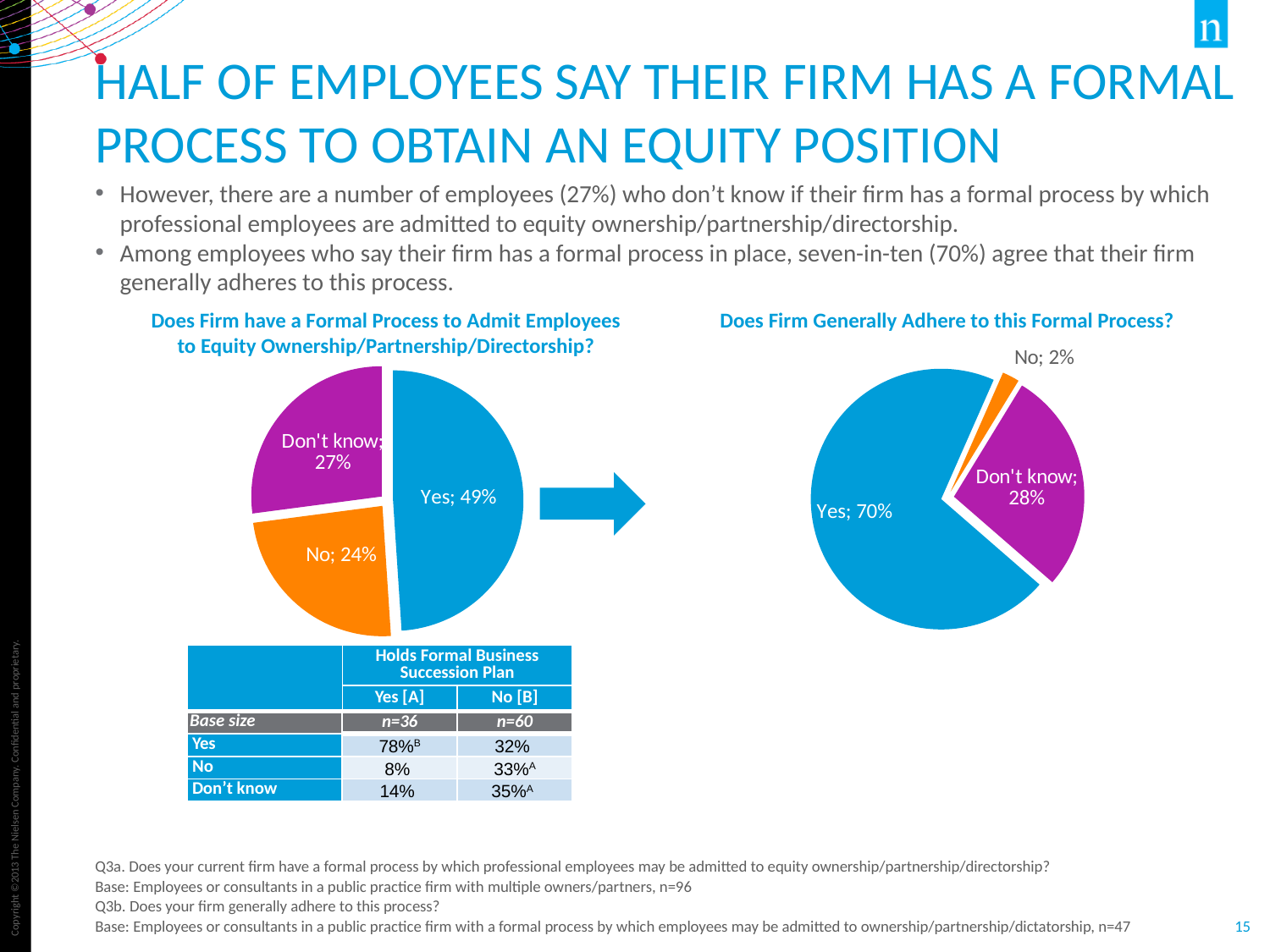
In the 'Does Firm Generally Adhere to this Formal Process?' chart, what percentage answered No? 2% In the 'Does Firm Generally Adhere to this Formal Process?' chart, what percentage answered Yes? 70% In the 'Does Firm have a Formal Process to Admit Employees to Equity Ownership/Partnership/Directorship?' chart, what is the difference in percentage points between Yes and No? 25 How many slices does the 'Does Firm Generally Adhere to this Formal Process?' chart have? 3 In the 'Does Firm Generally Adhere to this Formal Process?' chart, which response has the largest share? Yes What type of chart is used for 'Does Firm have a Formal Process to Admit Employees to Equity Ownership/Partnership/Directorship?'? Pie chart In the 'Does Firm have a Formal Process to Admit Employees to Equity Ownership/Partnership/Directorship?' chart, what percentage answered Don't know? 27% In the 'Does Firm have a Formal Process to Admit Employees to Equity Ownership/Partnership/Directorship?' chart, what percentage answered Yes? 49% In the 'Does Firm Generally Adhere to this Formal Process?' chart, what is the difference in percentage points between Yes and Don't know? 42 In the 'Does Firm Generally Adhere to this Formal Process?' chart, what colour is the Don't know slice? Purple In the 'Does Firm have a Formal Process to Admit Employees to Equity Ownership/Partnership/Directorship?' chart, which is larger: Don't know or No? Don't know In the 'Does Firm have a Formal Process to Admit Employees to Equity Ownership/Partnership/Directorship?' chart, which response has the smallest share? No